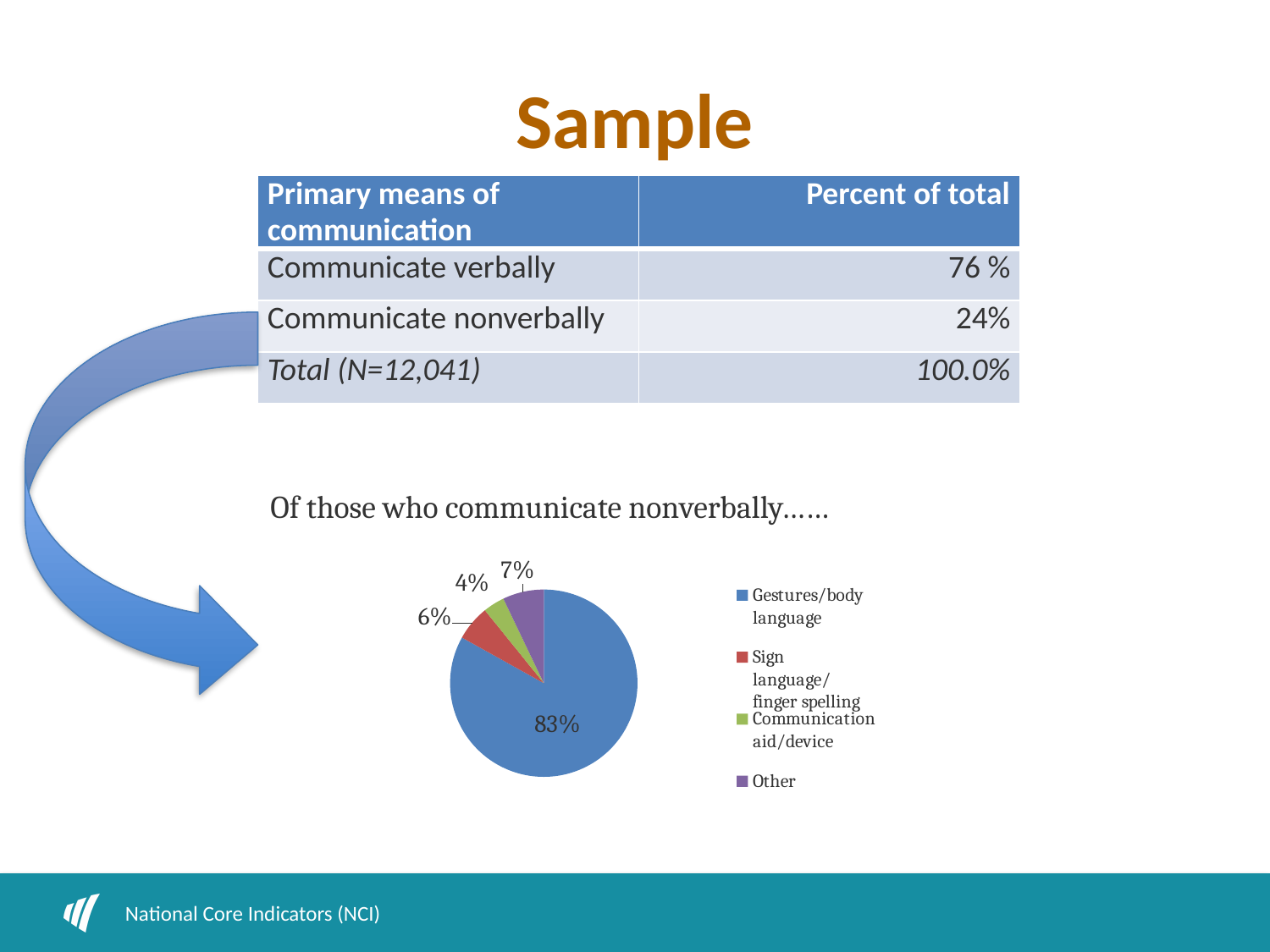
Which category has the smallest slice in the pie chart? Communication aid/device How many categories does the pie chart legend list? 4 Which is larger in the pie chart: Other or Sign language/finger spelling? Other What kind of chart is shown on the slide? pie chart What text introduces the pie chart on the slide? Of those who communicate nonverbally…… What is the difference in percentage points between Gestures/body language and Other in the pie chart? 76 In the pie chart, what percentage is shown for Communication aid/device? 4% Which category has the largest slice in the pie chart? Gestures/body language In the pie chart, what percentage is shown for Gestures/body language? 83% In the pie chart, what percentage is shown for Other? 7% What colour is the Gestures/body language slice in the pie chart? blue In the pie chart, what percentage is shown for Sign language/finger spelling? 6%